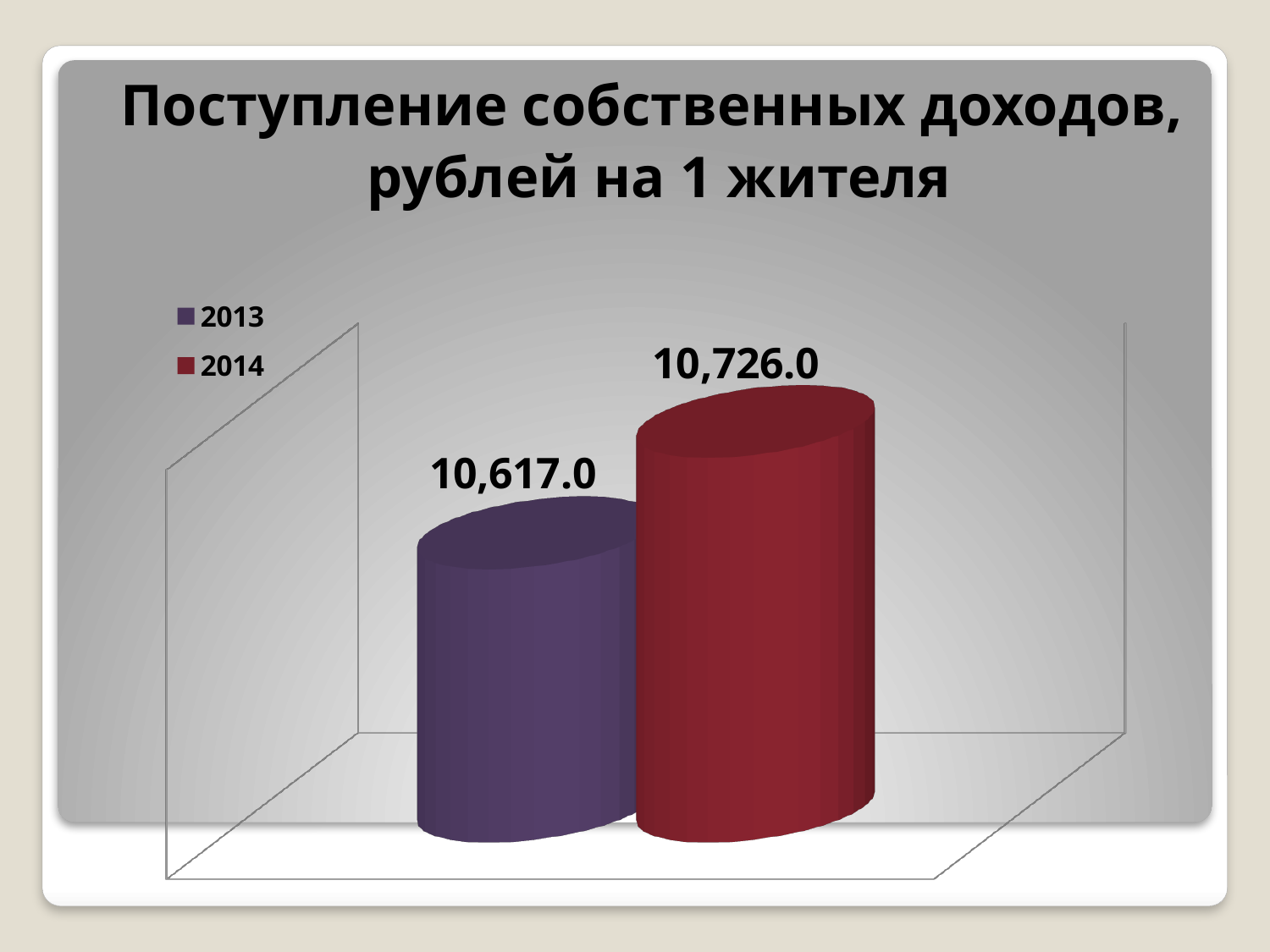
Which year has the lower value? 2013 What is the difference between the 2014 value and the 2013 value? 109.0 What is the value for 2013? 10,617.0 What is the title of the chart? Поступление собственных доходов, рублей на 1 жителя Which year has the higher value? 2014 How many series does the legend list? 2 What kind of chart is shown on the slide? bar chart Is the value for 2014 larger or smaller than the value for 2013? larger Does the value rise or fall from 2013 to 2014? rise What is the value for 2014? 10,726.0 How many bars are plotted on the chart? 2 What colour is the bar for 2014? red